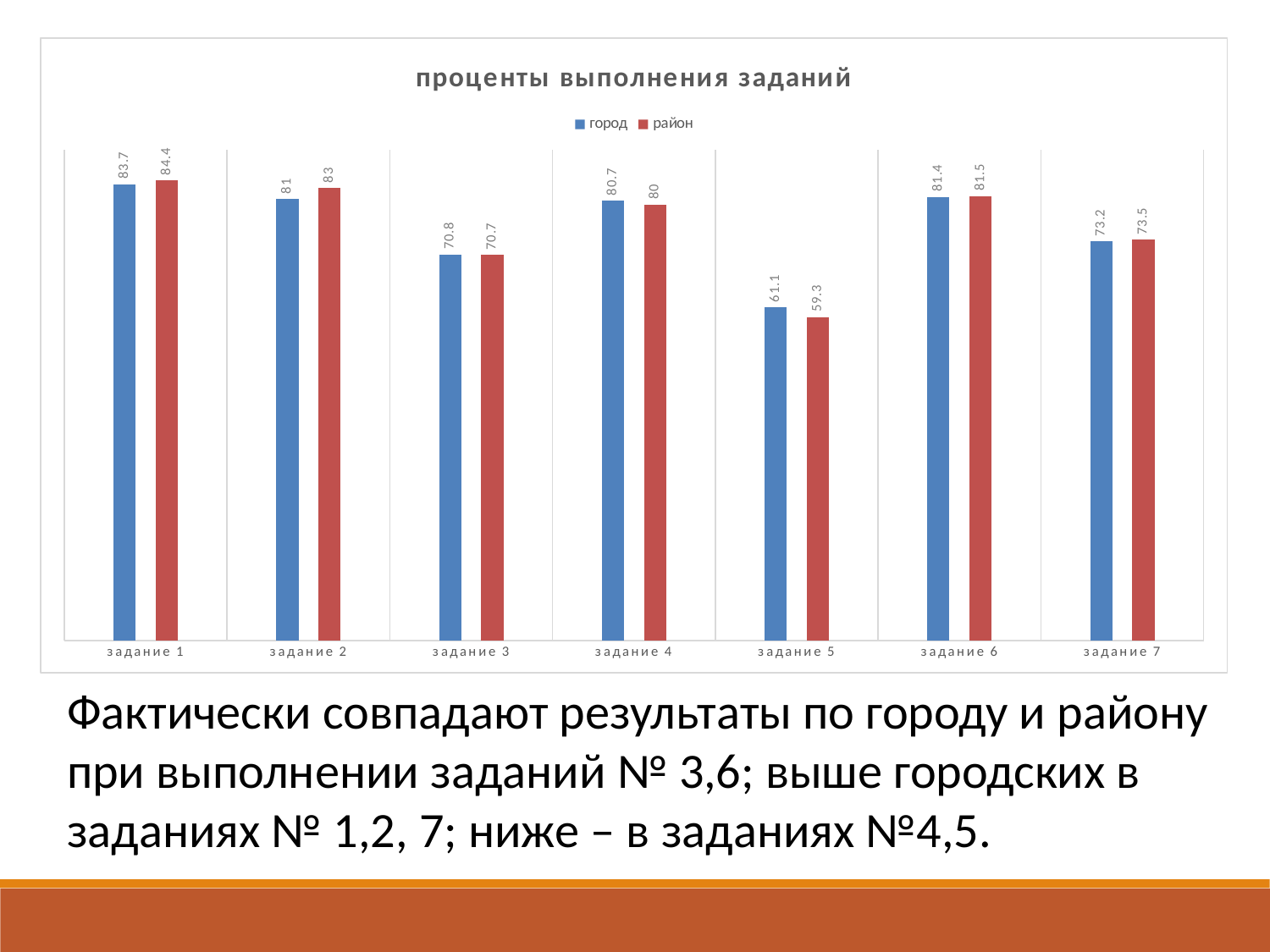
What is the difference between the район and город values for задание 5? 1.8 What kind of chart is shown on the slide? bar chart What is the value for город for задание 1? 83.7 Which task has the highest value for район? задание 1 How many tasks (categories) are shown on the x axis? 7 How many series does the legend list? 2 What is the value for район for задание 7? 73.5 What is the title of the chart? проценты выполнения заданий What is the difference between the район and город values for задание 2? 2 Which task has the lowest value for город? задание 5 What is the value for район for задание 5? 59.3 For задание 4, which is larger: город or район? город